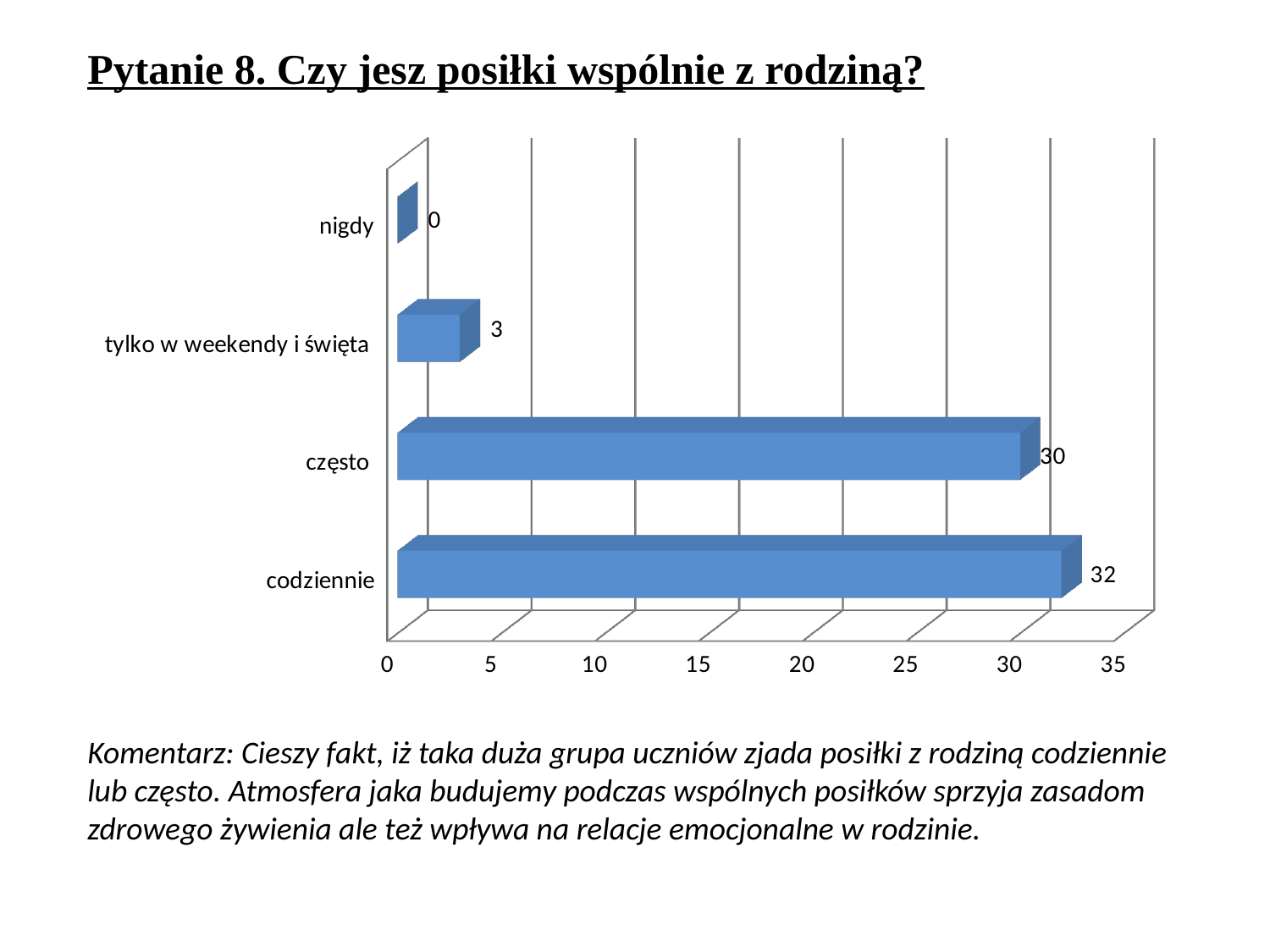
Which is larger, the value for "tylko w weekendy i święta" or the value for "często"? często What is the difference between the values for "często" and "tylko w weekendy i święta"? 27 How many categories are shown in the chart? 4 What is the value for "codziennie"? 32 Which category has the lowest value? nigdy What kind of chart is shown on the slide? bar chart What is the highest tick value shown on the horizontal axis? 35 What is the value for "często"? 30 Which category has the highest value? codziennie What is the difference between the values for "codziennie" and "często"? 2 What is the value for "tylko w weekendy i święta"? 3 What is the value for "nigdy"? 0